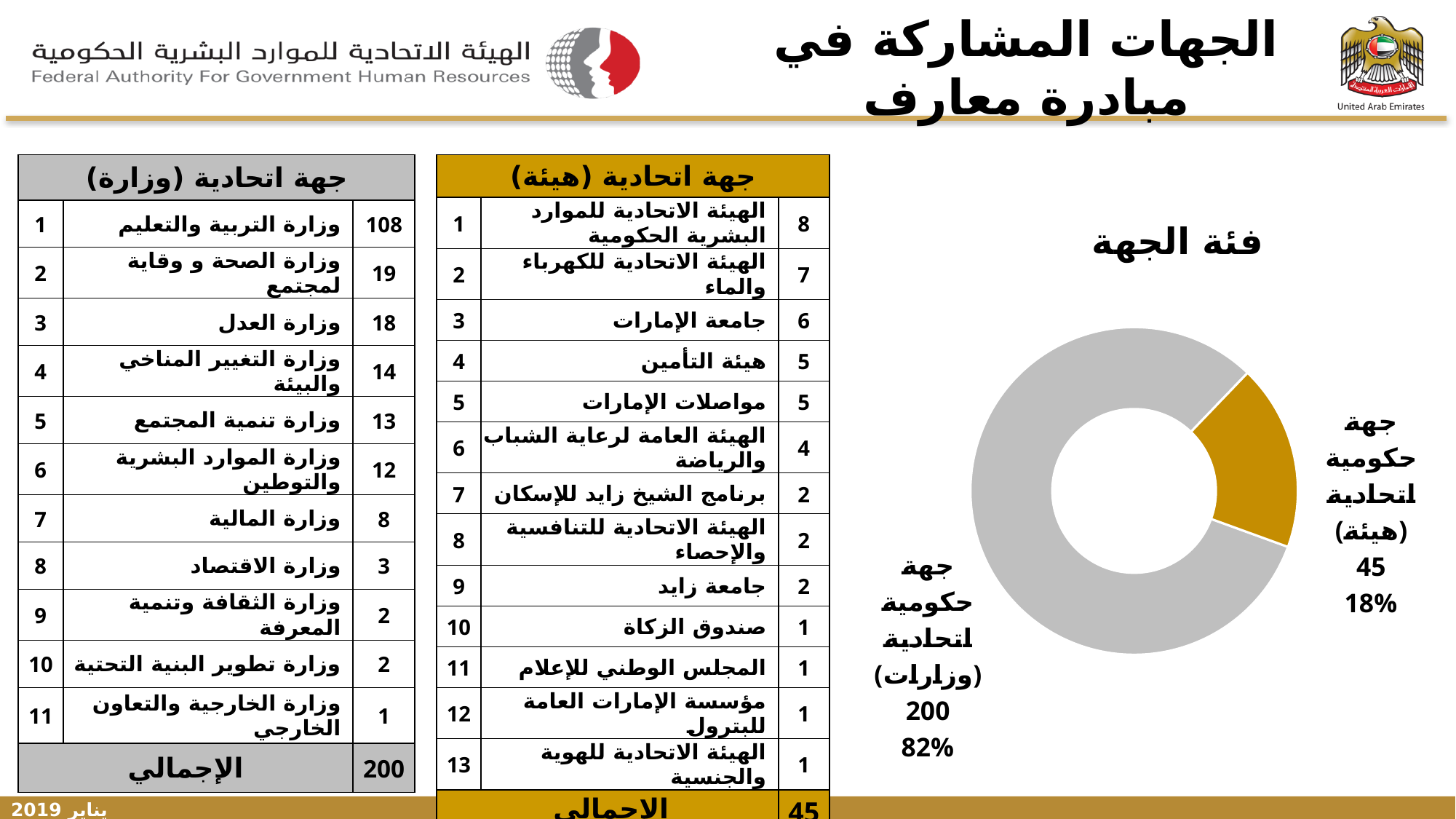
What kind of chart is shown on the slide? doughnut chart What is the difference between the values for جهة حكومية اتحادية (وزارات) and جهة حكومية اتحادية (هيئة) in the chart? 155 What share of the chart does جهة حكومية اتحادية (وزارات) represent? 82% What share of the chart does جهة حكومية اتحادية (هيئة) represent? 18% Which category has the largest slice in the chart? جهة حكومية اتحادية (وزارات) How many slices does the chart have? 2 Which category has the smallest slice in the chart? جهة حكومية اتحادية (هيئة) What is the title of the chart on the slide? فئة الجهة What colour is the slice for جهة حكومية اتحادية (هيئة) in the chart? gold What is the value for جهة حكومية اتحادية (هيئة) in the chart? 45 Which is larger in the chart: جهة حكومية اتحادية (هيئة) or جهة حكومية اتحادية (وزارات)? جهة حكومية اتحادية (وزارات) What is the value for جهة حكومية اتحادية (وزارات) in the chart? 200